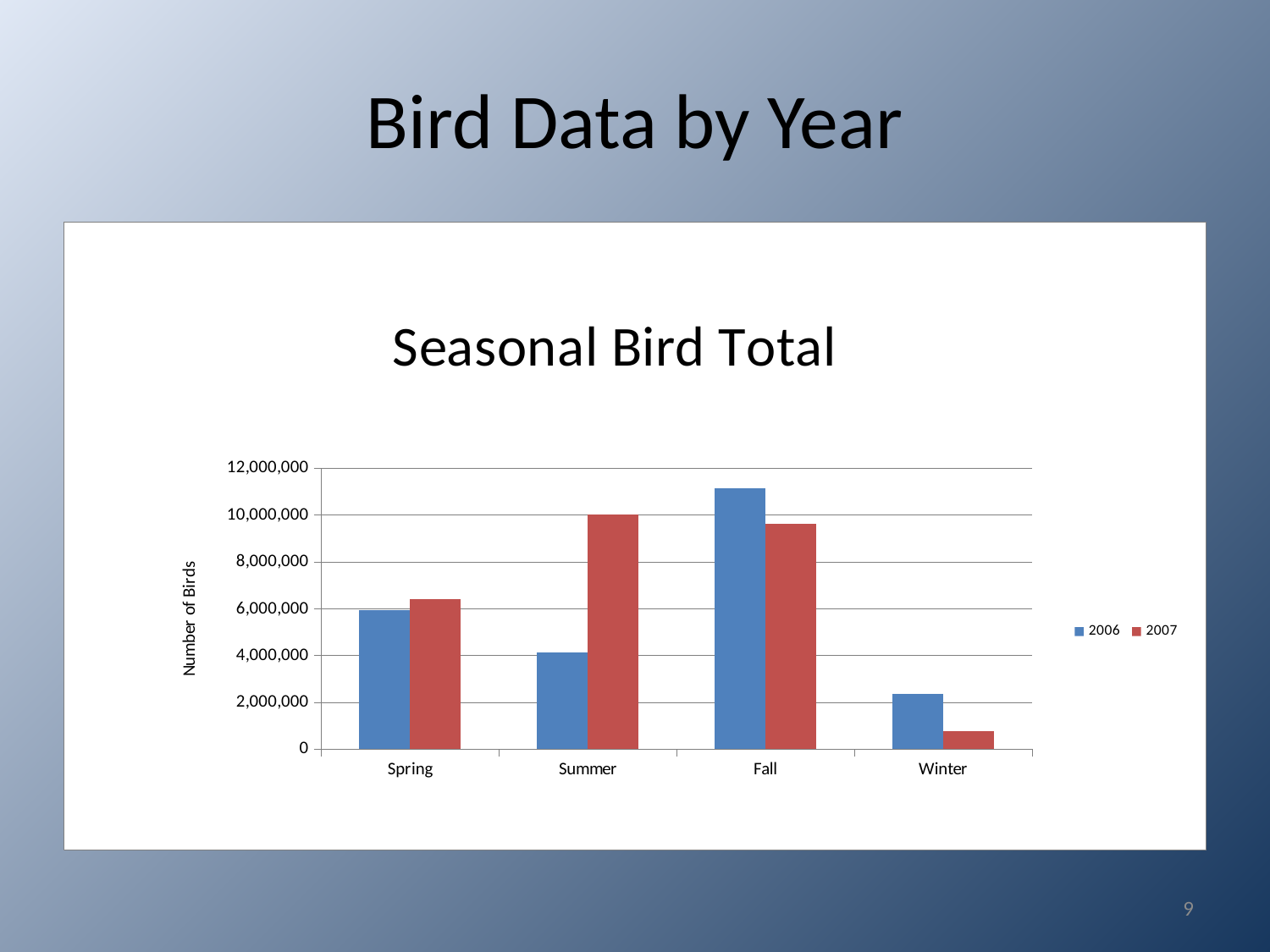
How many series does the legend list? 2 In Summer, which year has the larger value, 2006 or 2007? 2007 Which season has the highest value for 2006? Fall Which season has the lowest value for 2006? Winter Which season has the lowest value for 2007? Winter What kind of chart is shown on the slide? Bar chart How many seasons are shown on the x axis of the chart? 4 In Fall, which year has the larger value, 2006 or 2007? 2006 What is the title of the chart? Seasonal Bird Total Which season has the highest value for 2007? Summer Is the value for Winter in 2007 greater or less than 2,000,000? less Is the value for Fall in 2006 greater or less than 10,000,000? greater